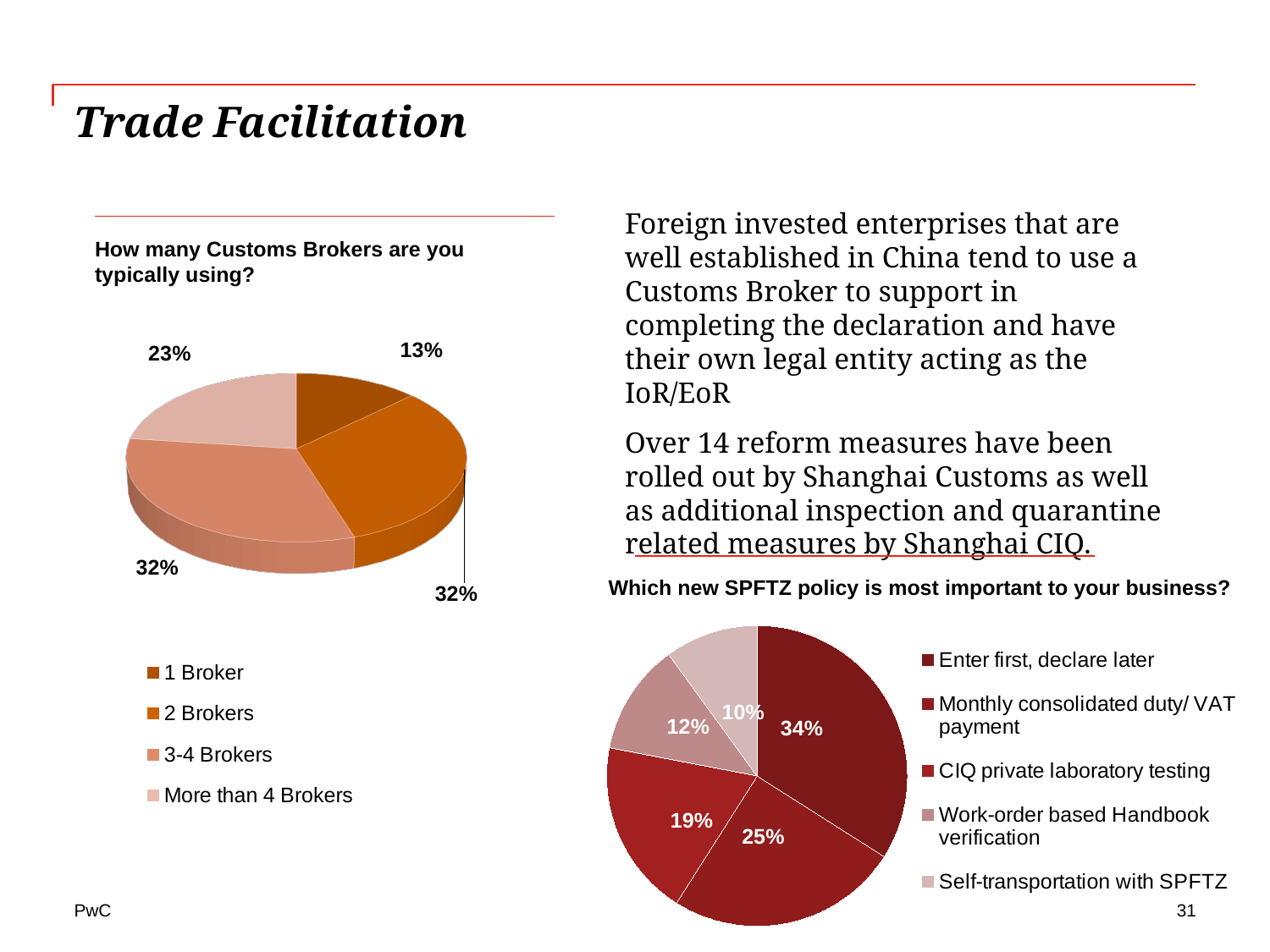
In the 'Which new SPFTZ policy is most important to your business?' chart, which policy has the largest share? Enter first, declare later In the 'How many Customs Brokers are you typically using?' chart, how many categories does the legend list? 4 In the 'How many Customs Brokers are you typically using?' chart, which category has the smallest share? 1 Broker In the 'Which new SPFTZ policy is most important to your business?' chart, what share is shown for CIQ private laboratory testing? 19% What kind of chart is used for 'How many Customs Brokers are you typically using?' Pie chart In the 'Which new SPFTZ policy is most important to your business?' chart, which policy has the smallest share? Self-transportation with SPFTZ In the 'How many Customs Brokers are you typically using?' chart, what share of respondents use More than 4 Brokers? 23% In the 'How many Customs Brokers are you typically using?' chart, what share of respondents use 1 Broker? 13% In the 'Which new SPFTZ policy is most important to your business?' chart, which is larger: Monthly consolidated duty/ VAT payment or Work-order based Handbook verification? Monthly consolidated duty/ VAT payment In the 'Which new SPFTZ policy is most important to your business?' chart, how many policies does the legend list? 5 In the 'Which new SPFTZ policy is most important to your business?' chart, what share is shown for Enter first, declare later? 34% In the 'How many Customs Brokers are you typically using?' chart, what is the difference between the share for More than 4 Brokers and the share for 1 Broker? 10%